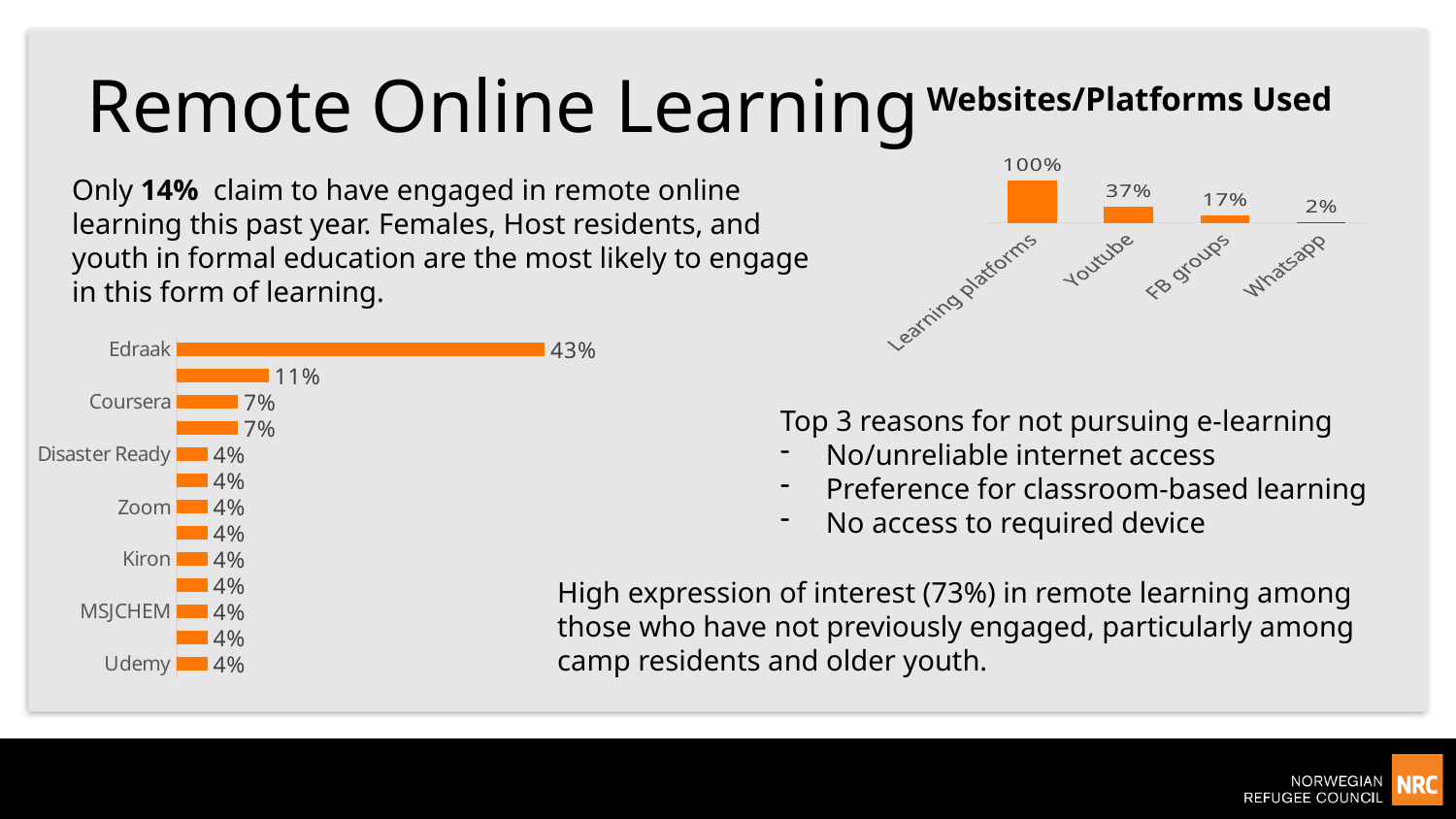
In the horizontal bar chart on the left of the slide, which category has the highest value? Edraak In the 'Websites/Platforms Used' chart, what is the value for Youtube? 37% In the horizontal bar chart on the left of the slide, what is the value for Edraak? 43% In the 'Websites/Platforms Used' chart, which category has the highest value? Learning platforms In the 'Websites/Platforms Used' chart, what is the value for FB groups? 17% In the horizontal bar chart on the left of the slide, what is the value for Coursera? 7% What kind of chart is the 'Websites/Platforms Used' chart? Bar chart In the horizontal bar chart on the left of the slide, what is the difference between Edraak and Coursera? 36% In the horizontal bar chart on the left of the slide, which is larger, Coursera or Zoom? Coursera How many categories are shown in the 'Websites/Platforms Used' chart? 4 In the 'Websites/Platforms Used' chart, which category has the lowest value? Whatsapp In the 'Websites/Platforms Used' chart, what is the difference between Youtube and FB groups? 20%